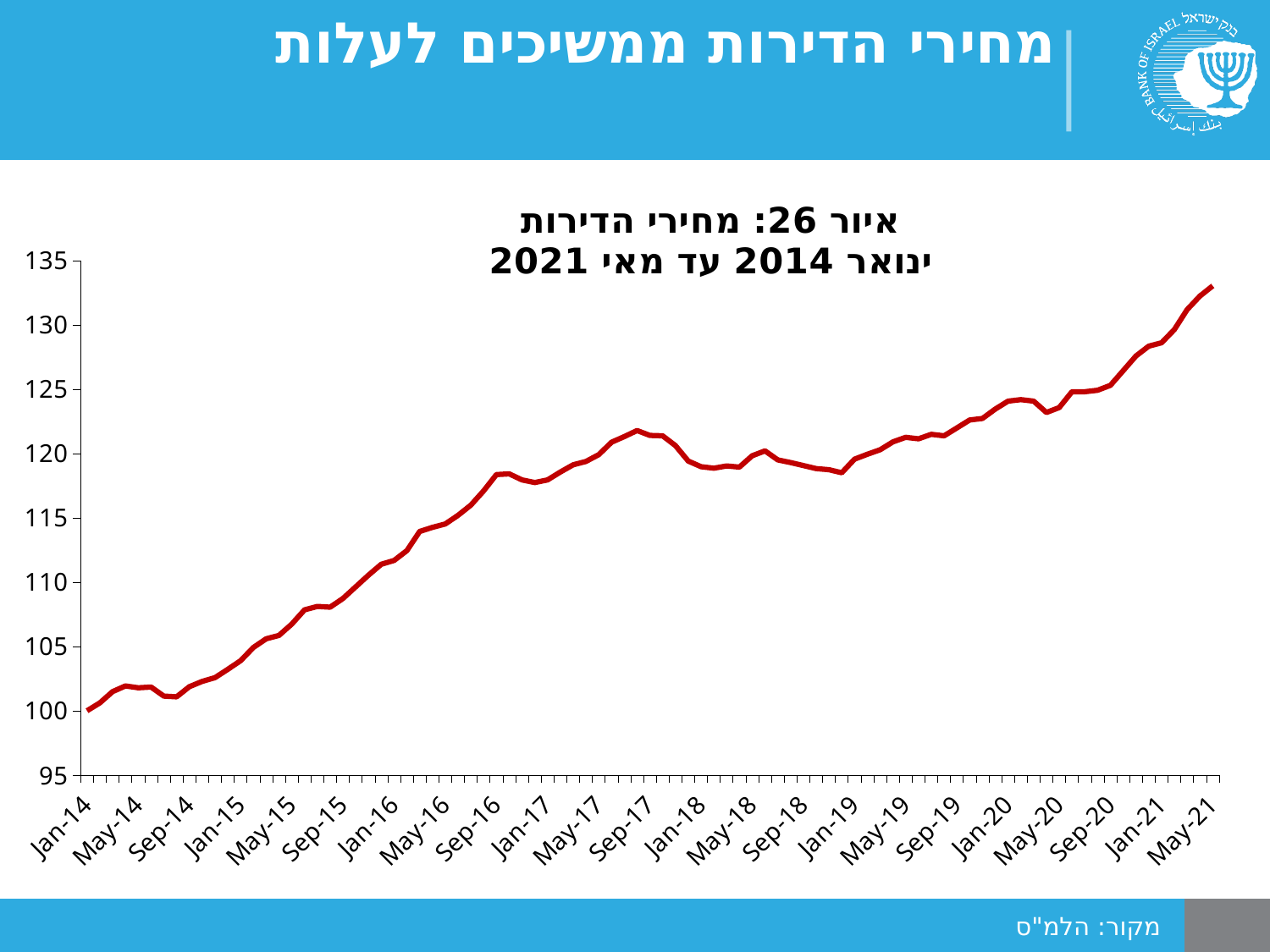
What is the value of the index at Jan-14? 100 At which date is the housing price index highest? May-21 At which date is the housing price index lowest? Jan-14 Is the value for Jan-21 greater or less than 125? greater Is the value for Sep-15 greater or less than 110? less Which is larger, the value at Sep-17 or the value at Jan-19? Sep-17 Overall, do housing prices rise or fall from Jan-14 to May-21? rise What kind of chart is shown on the slide? line chart Is the value for May-21 greater or less than 130? greater What colour is the line in the chart? red What is the title of the chart? איור 26: מחירי הדירות ינואר 2014 עד מאי 2021